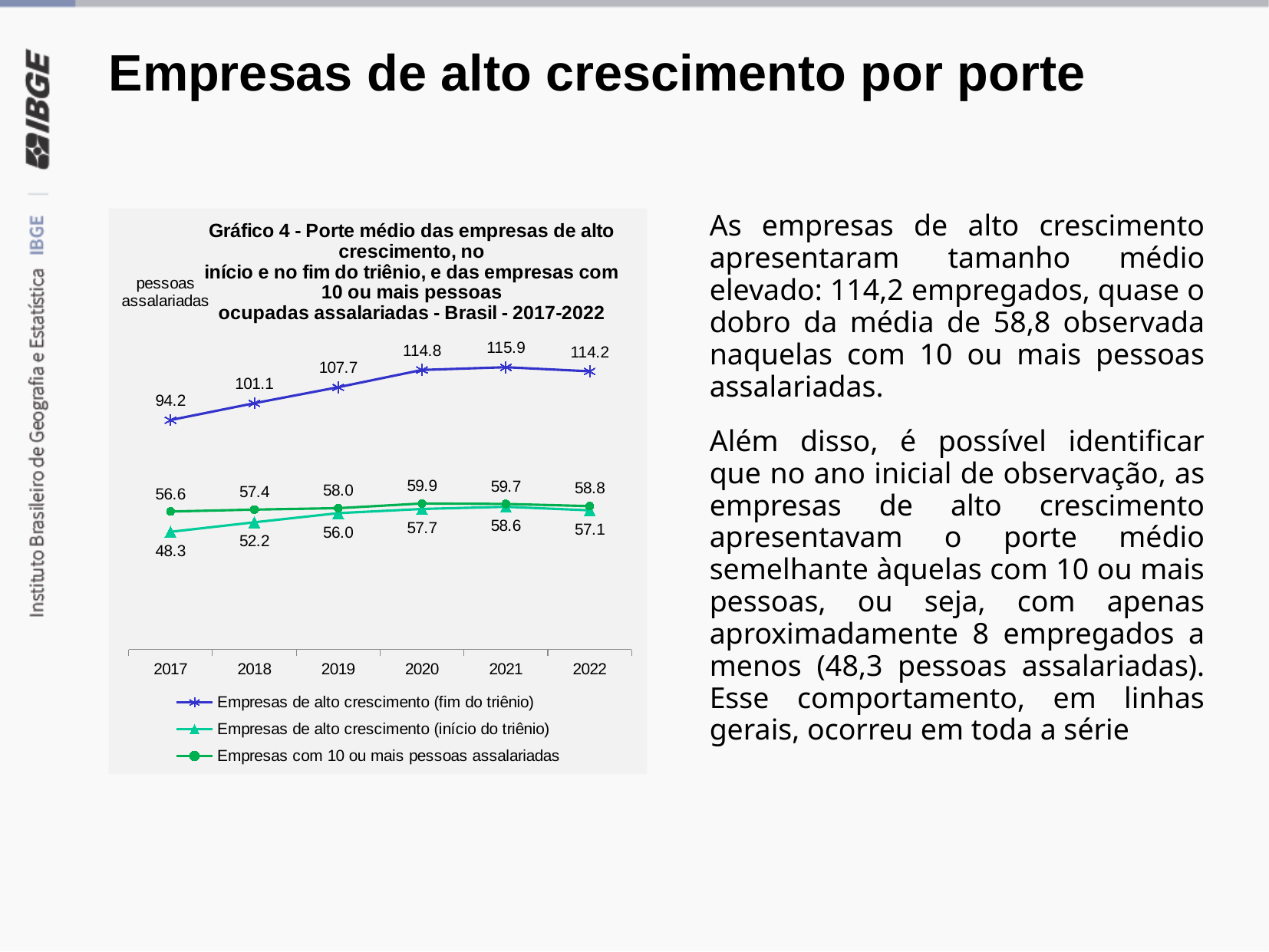
Which series is drawn with a blue line and asterisk markers? Empresas de alto crescimento (fim do triênio) Does the Empresas de alto crescimento (fim do triênio) series rise or fall from 2017 to 2020? Rise What is the value for Empresas de alto crescimento (início do triênio) in 2022? 57.1 What is the value for Empresas com 10 ou mais pessoas assalariadas in 2020? 59.9 How many series does the legend list? 3 In which year is the Empresas de alto crescimento (início do triênio) series at its lowest value? 2017 In 2019, which is larger: Empresas com 10 ou mais pessoas assalariadas or Empresas de alto crescimento (início do triênio)? Empresas com 10 ou mais pessoas assalariadas How many years are shown on the x axis? 6 What is the difference between the 2022 values of Empresas de alto crescimento (fim do triênio) and Empresas com 10 ou mais pessoas assalariadas? 55.4 What kind of chart is shown on the slide? Line chart In which year does the Empresas de alto crescimento (fim do triênio) series reach its highest value? 2021 What is the value for Empresas de alto crescimento (fim do triênio) in 2017? 94.2